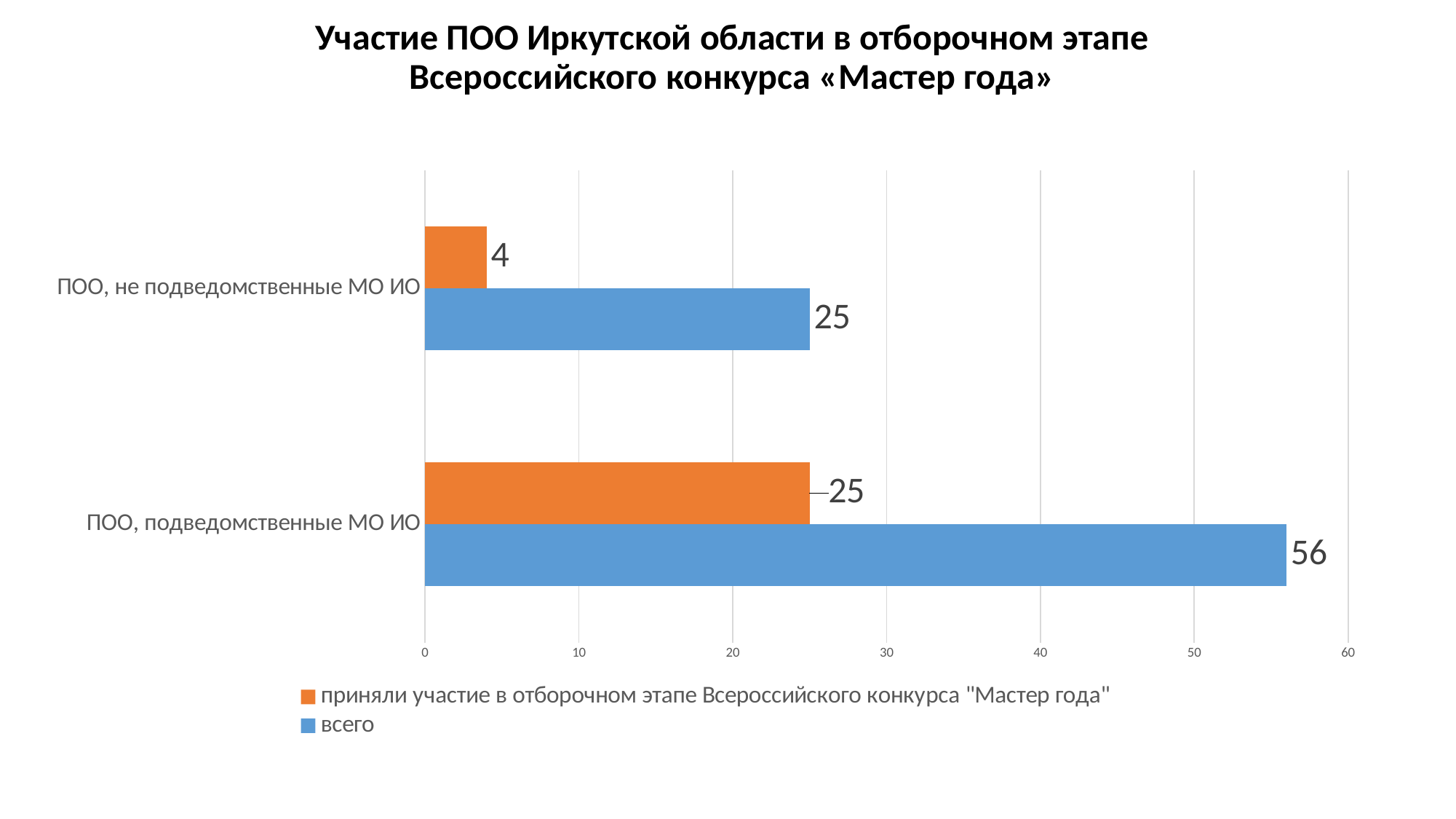
How many categories are shown on the chart? 2 How many "ПОО, не подведомственные МО ИО" took part in the selection stage ("приняли участие" series)? 4 What is the "всего" value for "ПОО, не подведомственные МО ИО"? 25 Which is larger: the "приняли участие" value for "ПОО, подведомственные МО ИО" or for "ПОО, не подведомственные МО ИО"? ПОО, подведомственные МО ИО What is the "всего" value for "ПОО, подведомственные МО ИО"? 56 Which category has the highest "всего" value? ПОО, подведомственные МО ИО What is the difference between the "всего" and "приняли участие" values for "ПОО, не подведомственные МО ИО"? 21 Which category has the lowest "приняли участие" value? ПОО, не подведомственные МО ИО What kind of chart is shown on the slide? Bar chart How many series does the legend list? 2 What is the difference between the "всего" and "приняли участие" values for "ПОО, подведомственные МО ИО"? 31 What is the "приняли участие" value for "ПОО, подведомственные МО ИО"? 25